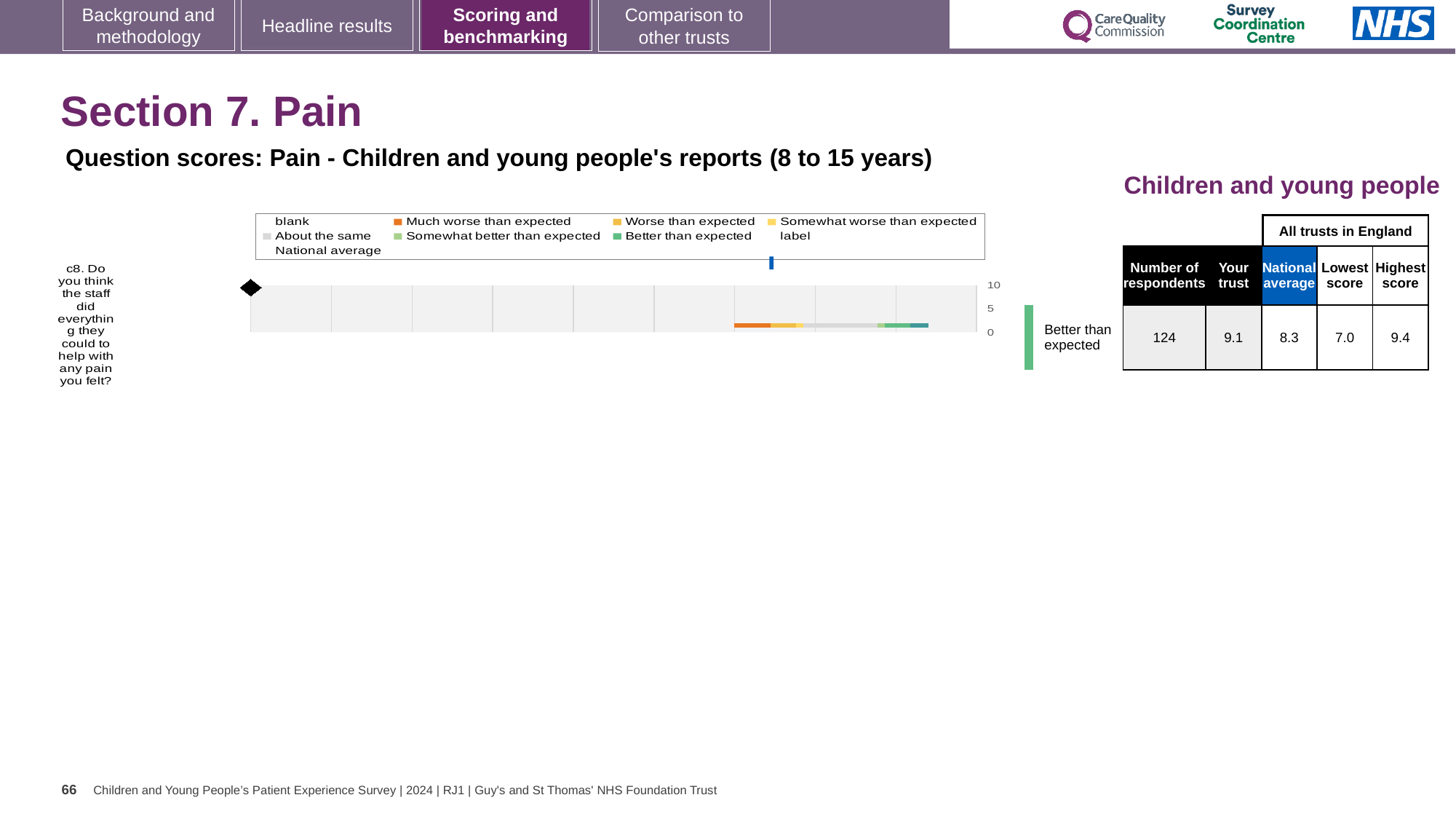
What is the highest score among all trusts in England for question c8? 9.4 What is the difference between the trust's score and the national average for question c8? 0.8 Which is larger for question c8, the trust's score or the national average? the trust's score What is the national average score for question c8? 8.3 How many entries does the chart legend list? 9 What is the lowest score among all trusts in England for question c8? 7.0 How many survey questions are plotted in the chart? 1 What is the 'Your trust' score for question c8? 9.1 How many respondents answered question c8? 124 What is the highest value shown on the chart's numeric axis? 10 What is the question label shown on the chart's category axis? c8. Do you think the staff did everything they could to help with any pain you felt? What kind of chart is shown on the slide? bar chart